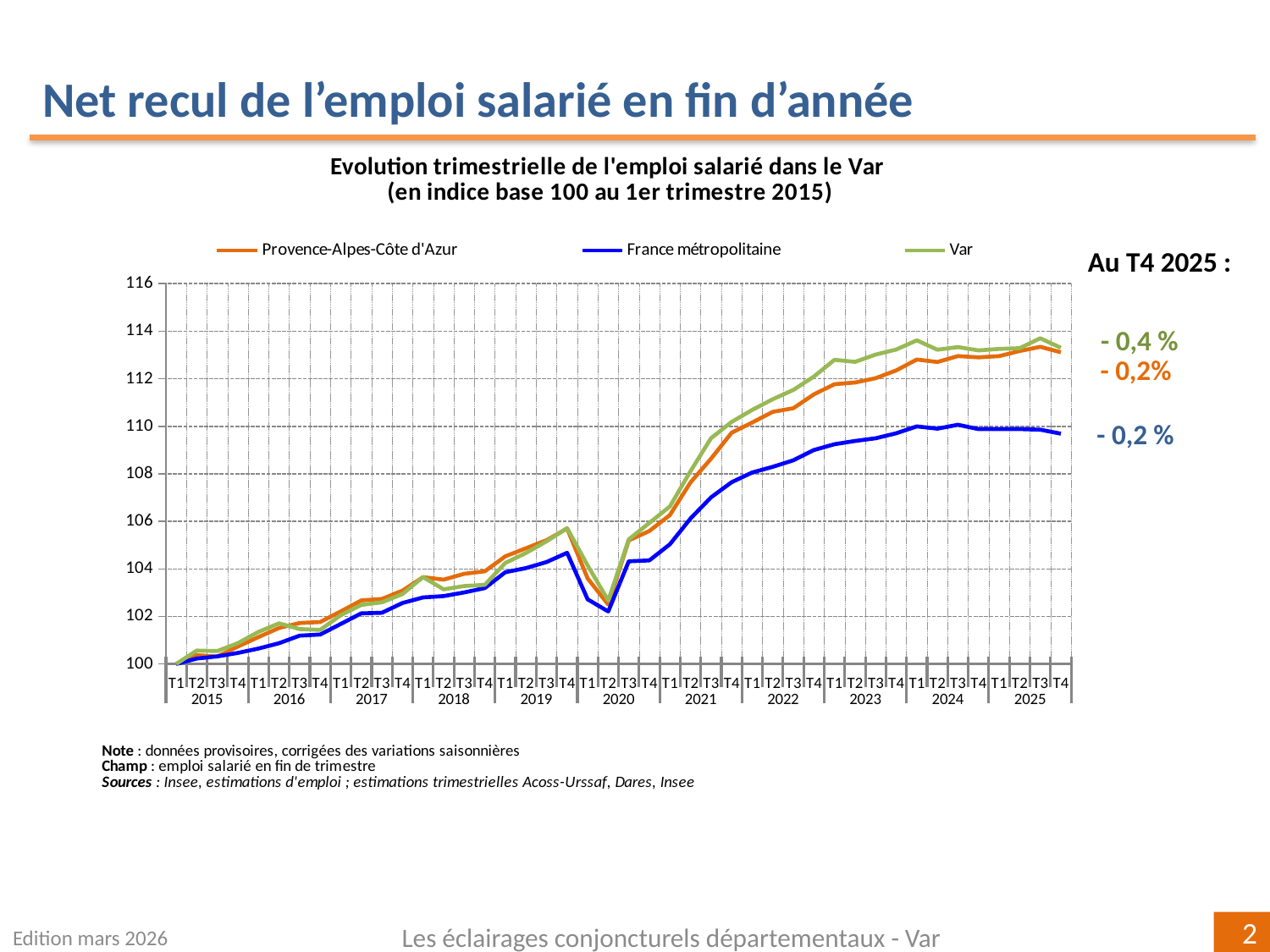
What change is shown for France métropolitaine at T4 2025? - 0,2 % Which series is drawn in blue? France métropolitaine Is the value for France métropolitaine at T4 2025 greater or less than 110? less Which series has the highest value at T1 2024? Var What change is shown for Var at T4 2025? - 0,4 % Is the value for France métropolitaine at T2 2020 greater or less than 104? less Which series has the lowest value at T4 2025? France métropolitaine What kind of chart is shown on the slide? line chart How many series does the legend list? 3 Overall, do the values for Var rise or fall from T1 2015 to T4 2025? rise What is the title of the chart? Evolution trimestrielle de l'emploi salarié dans le Var (en indice base 100 au 1er trimestre 2015) Is the value for Var at T1 2024 greater or less than 112? greater